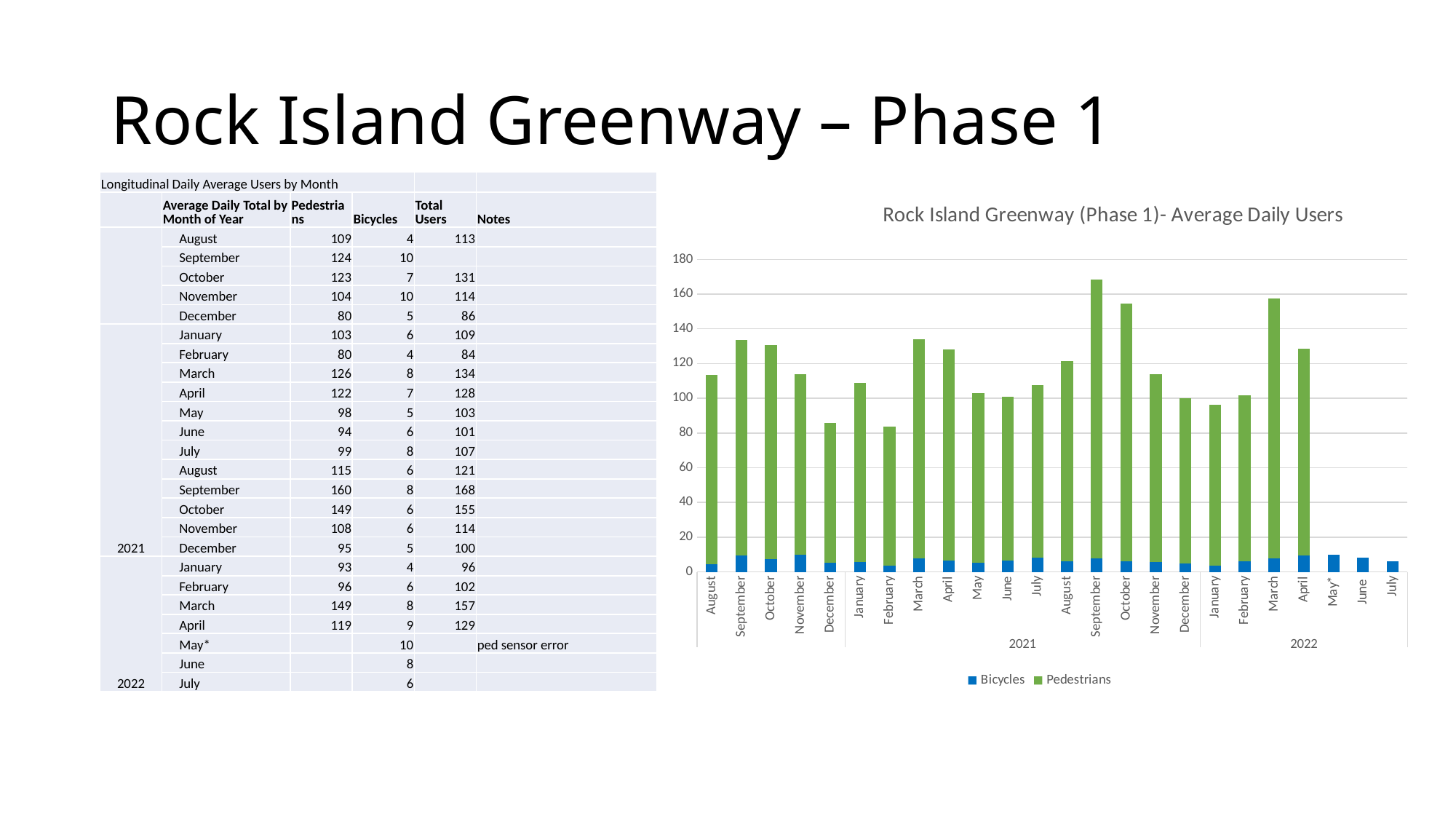
Is the total bar for March 2022 greater or less than 140? greater How many monthly bars are plotted in the chart? 24 What is the title of the chart? Rock Island Greenway (Phase 1)- Average Daily Users Which series is shown in green in the chart? Pedestrians What kind of chart is shown on the slide? stacked bar chart How many series does the chart legend list? 2 Do the bar heights rise or fall from September 2021 to December 2021? fall Is the total bar for February 2021 greater or less than 100? less Which bar is taller, March 2022 or April 2022? March 2022 Is the total bar for September 2021 greater or less than 160? greater Which month has the tallest bar in the chart? September 2021 According to the table on the slide, what is the Total Users value for September 2021? 168